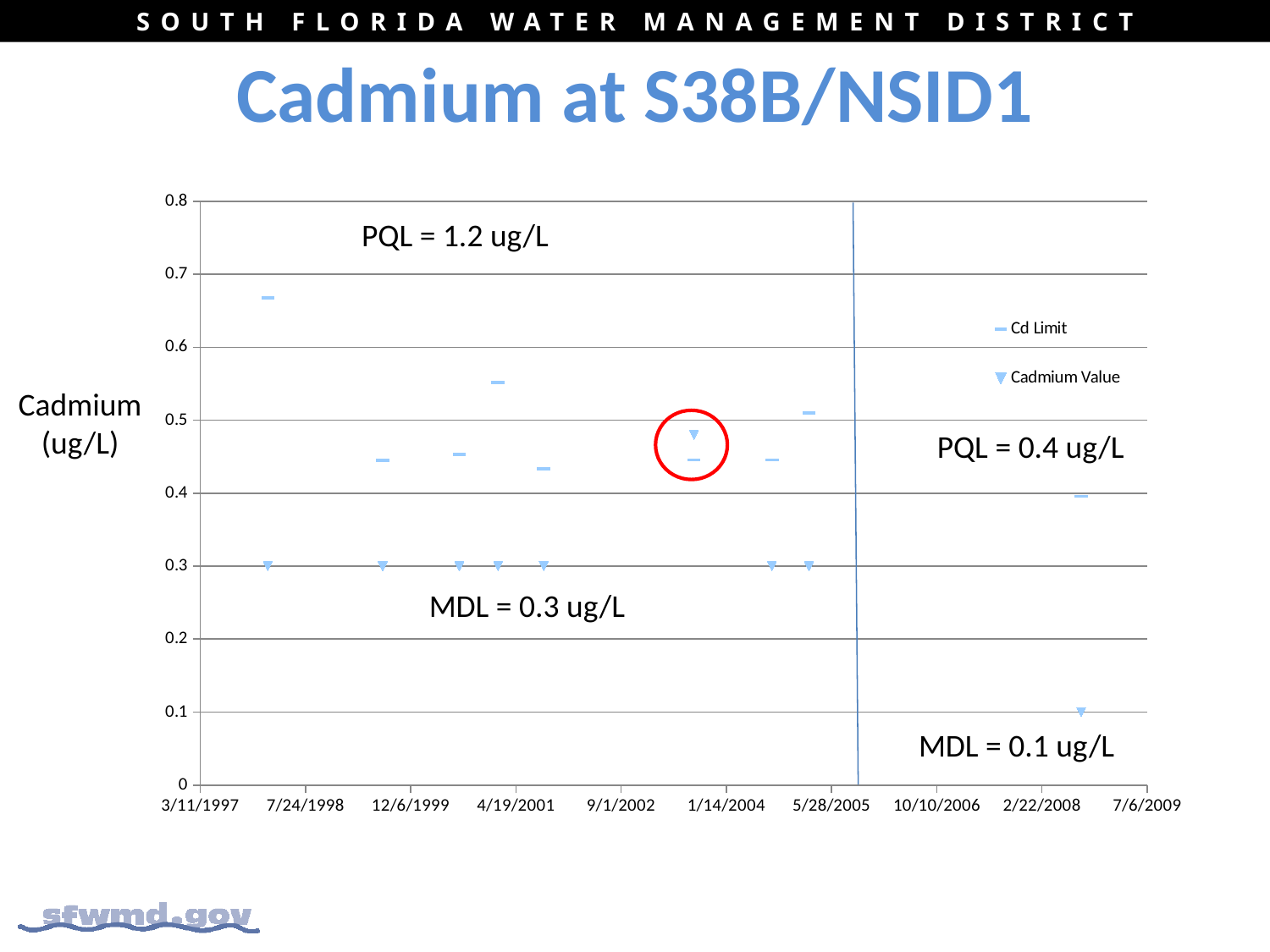
What is the title of the chart? Cadmium at S38B/NSID1 What kind of chart is shown on the slide? scatter chart Is the highest Cd Limit point (near 7/24/1998) greater or less than 0.6? greater At what value are most of the Cadmium Value points before 5/28/2005 plotted? 0.3 What is the value of the last Cadmium Value point, plotted after 2/22/2008? 0.1 Which is larger: the Cd Limit point just before the vertical line near 5/28/2005, or the Cd Limit point after 2/22/2008? the Cd Limit point near 5/28/2005 Do the Cadmium Value points fall or rise from the 2005 points to the 2008 point? fall How many series does the legend list? 2 What is the lowest Cadmium Value plotted on the chart? 0.1 What are the two series named in the legend? Cd Limit and Cadmium Value Is the circled Cadmium Value point greater or less than 0.4? greater Is the Cd Limit point near 4/19/2001 greater or less than 0.5? greater